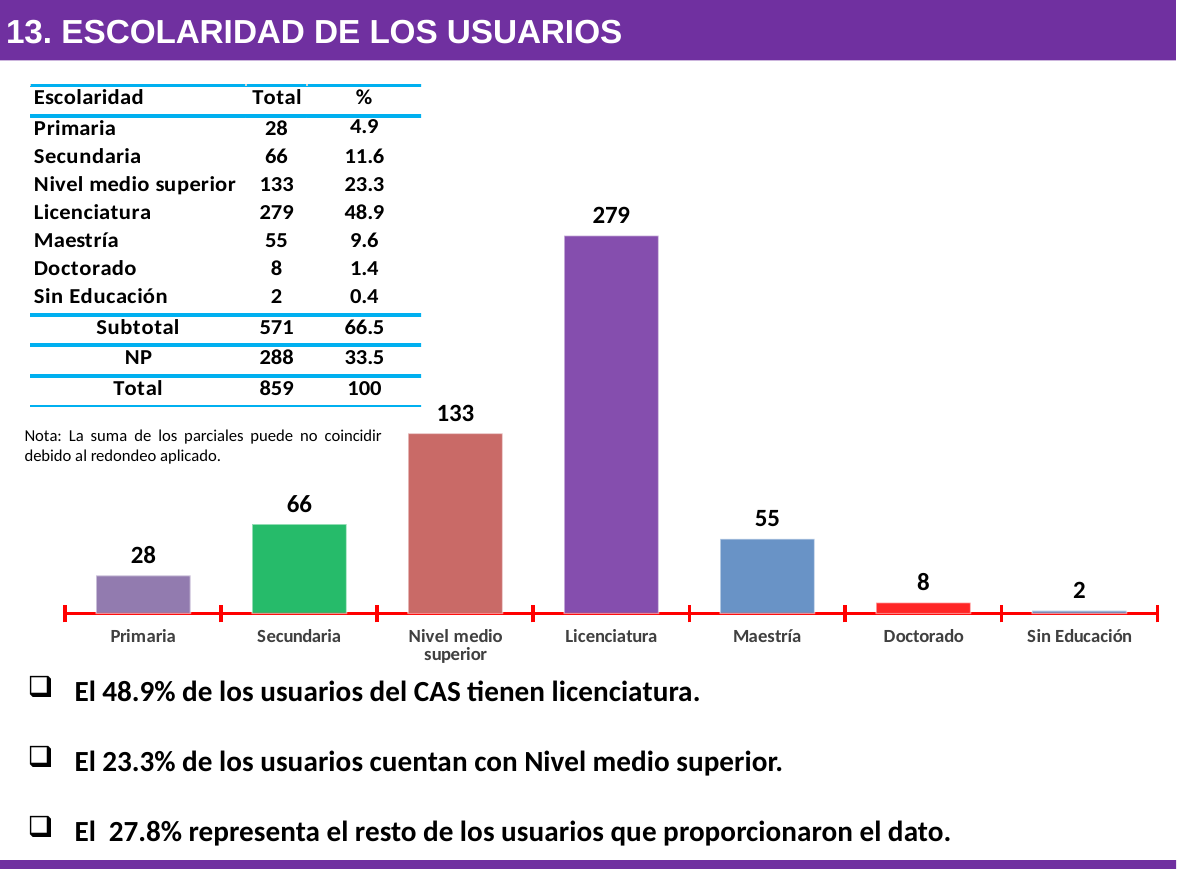
What colour is the bar for Secundaria? Green What is the value for Nivel medio superior in the bar chart? 133 Which is larger, the value for Primaria or the value for Maestría? Maestría What is the value for Doctorado in the bar chart? 8 What is the value for Secundaria in the bar chart? 66 How many categories are shown on the x axis of the bar chart? 7 What kind of chart is shown on the slide? Bar chart Which category has the highest value in the bar chart? Licenciatura What is the value for Licenciatura in the bar chart? 279 What is the difference between the values for Licenciatura and Nivel medio superior? 146 Which category has the lowest value in the bar chart? Sin Educación What is the difference between the values for Secundaria and Maestría? 11